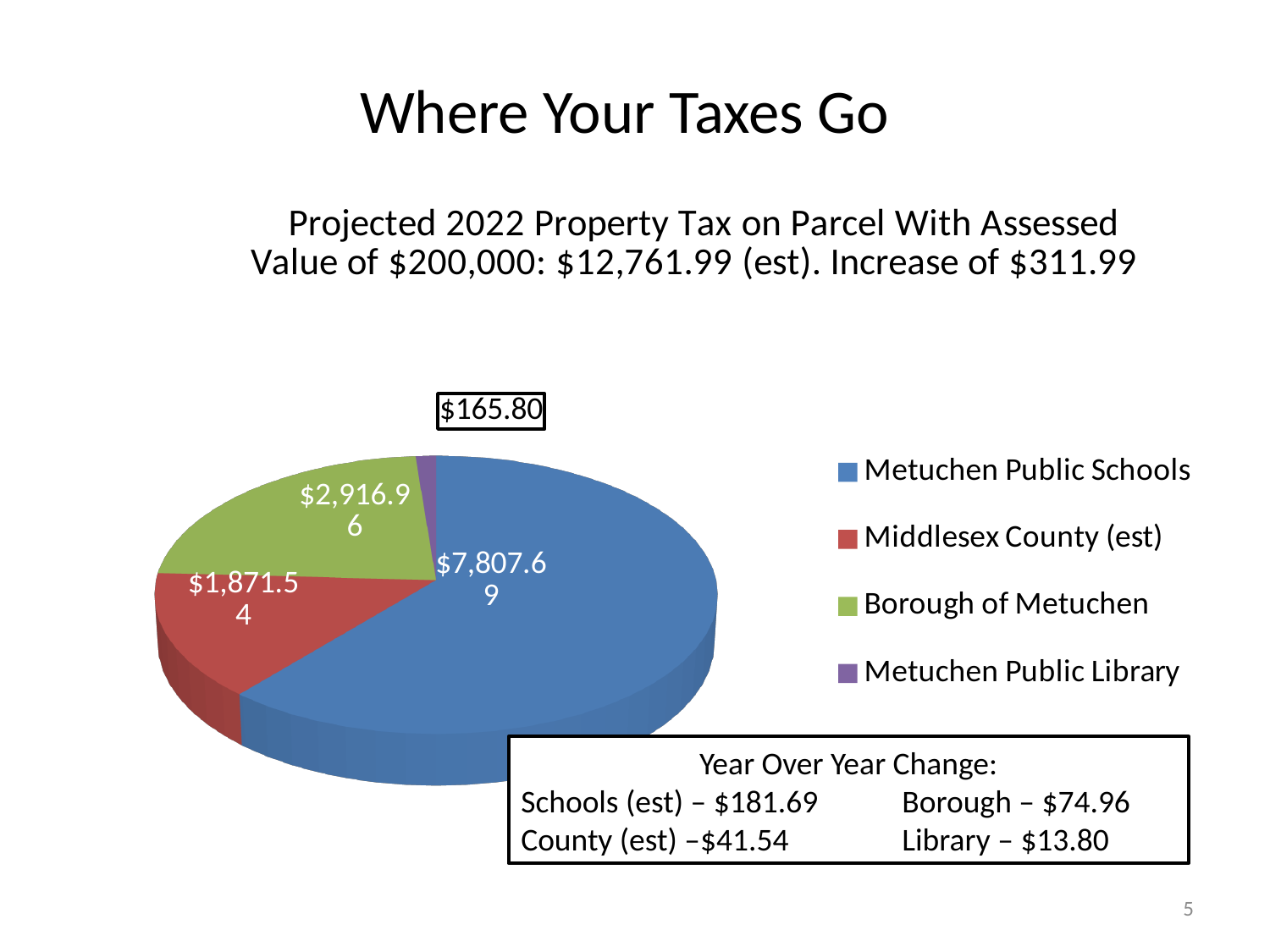
Which is larger, the value for Borough of Metuchen or the value for Middlesex County (est)? Borough of Metuchen How many entries does the legend list? 4 Which category has the smallest slice of the pie? Metuchen Public Library What is the value for Metuchen Public Library? $165.80 Which category has the largest slice of the pie? Metuchen Public Schools What kind of chart is shown on the slide? Pie chart What is the title of the slide containing the pie chart? Where Your Taxes Go What is the value for Metuchen Public Schools? $7,807.69 How many slices does the pie chart have? 4 What is the difference between the value for Metuchen Public Schools and the value for Borough of Metuchen? $4,890.73 What is the value for Borough of Metuchen? $2,916.96 What is the value for Middlesex County (est)? $1,871.54